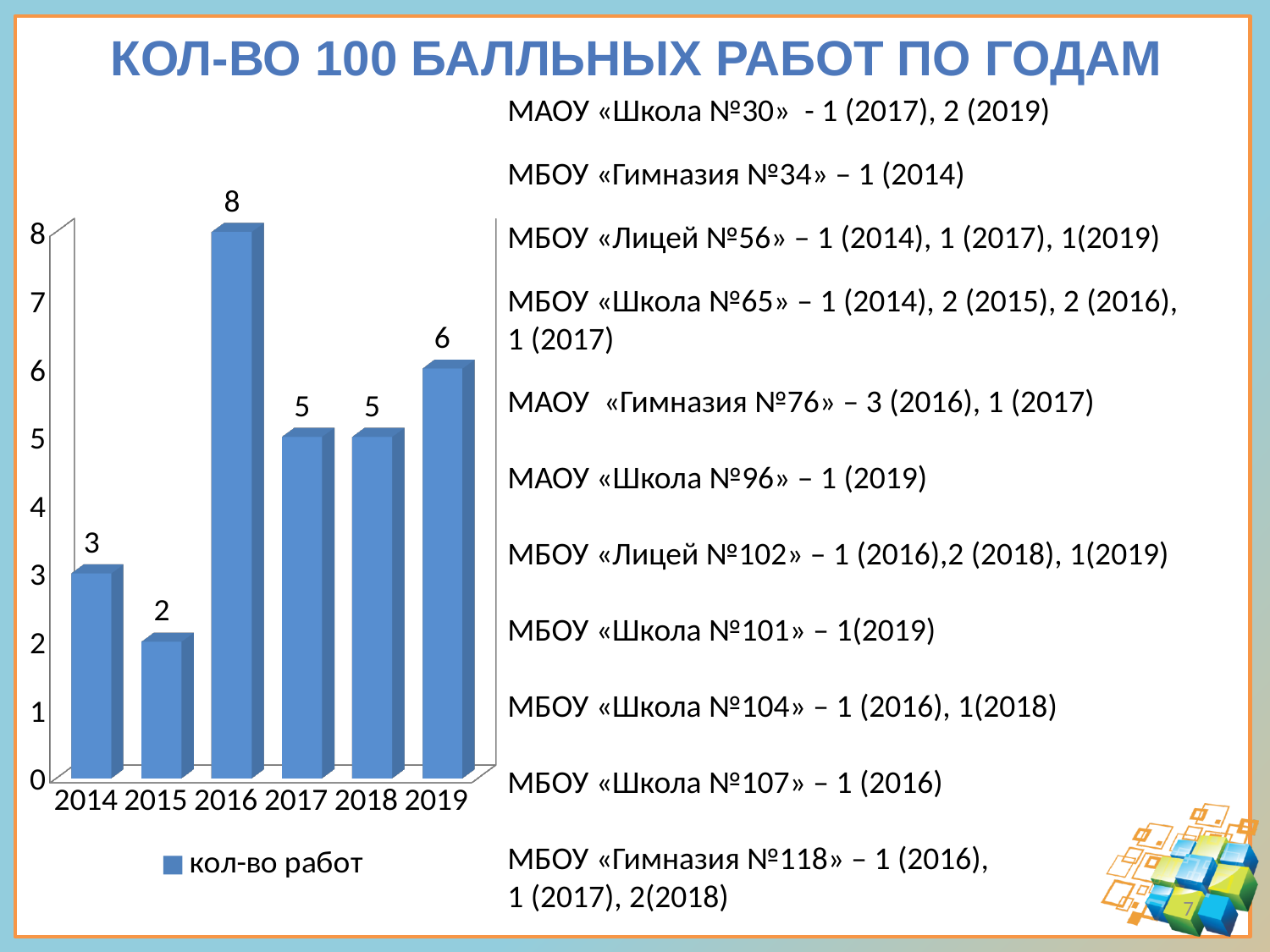
Do the values rise or fall from 2014 to 2016? neither; they fall from 2014 to 2015 then rise to 2016 What is the legend entry of the chart? кол-во работ What is the value for 2016? 8 Which is larger, the value for 2019 or the value for 2017? 2019 Which year has the lowest value? 2015 What is the value for 2019? 6 How many series does the legend list? 1 What kind of chart is shown? bar chart What is the value for 2014? 3 How many years are shown on the x axis? 6 What is the difference between the values for 2016 and 2015? 6 Which year has the highest value? 2016